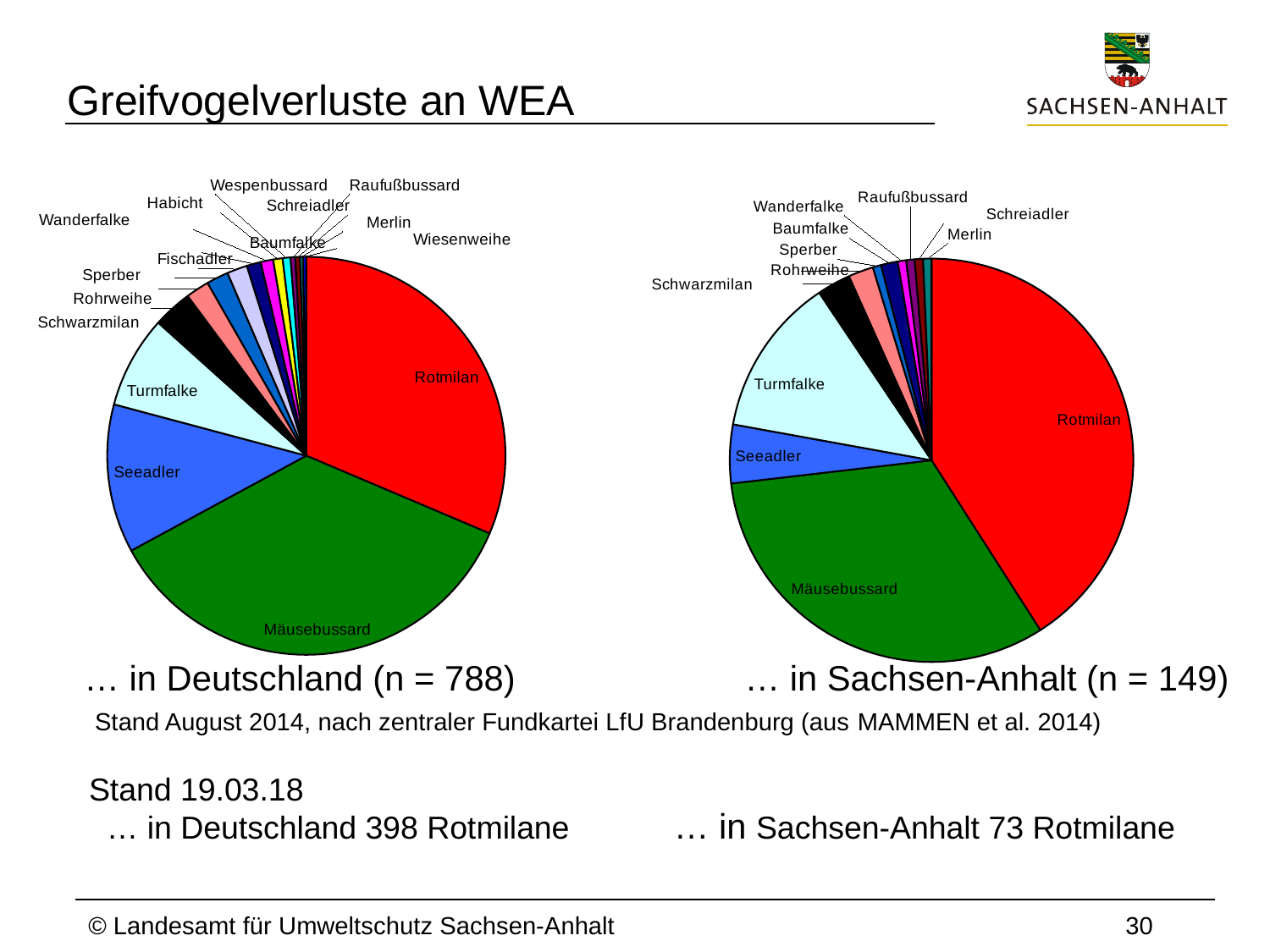
How many species slices are labelled in the left pie chart (Deutschland)? 16 In the right pie chart (Sachsen-Anhalt), which slice is larger, Turmfalke or Seeadler? Turmfalke In the right pie chart (Sachsen-Anhalt), which slice is larger, Mäusebussard or Turmfalke? Mäusebussard How many pie charts are shown on the slide? 2 How many species slices are labelled in the right pie chart (Sachsen-Anhalt)? 12 What colour is the Mäusebussard slice in both pie charts? green In the left pie chart (Deutschland), which slice is larger, Rotmilan or Turmfalke? Rotmilan What kind of chart is used on this slide? pie chart In the right pie chart (Sachsen-Anhalt), which species has the largest slice? Rotmilan What is the sample size n given for the left pie chart (Deutschland)? 788